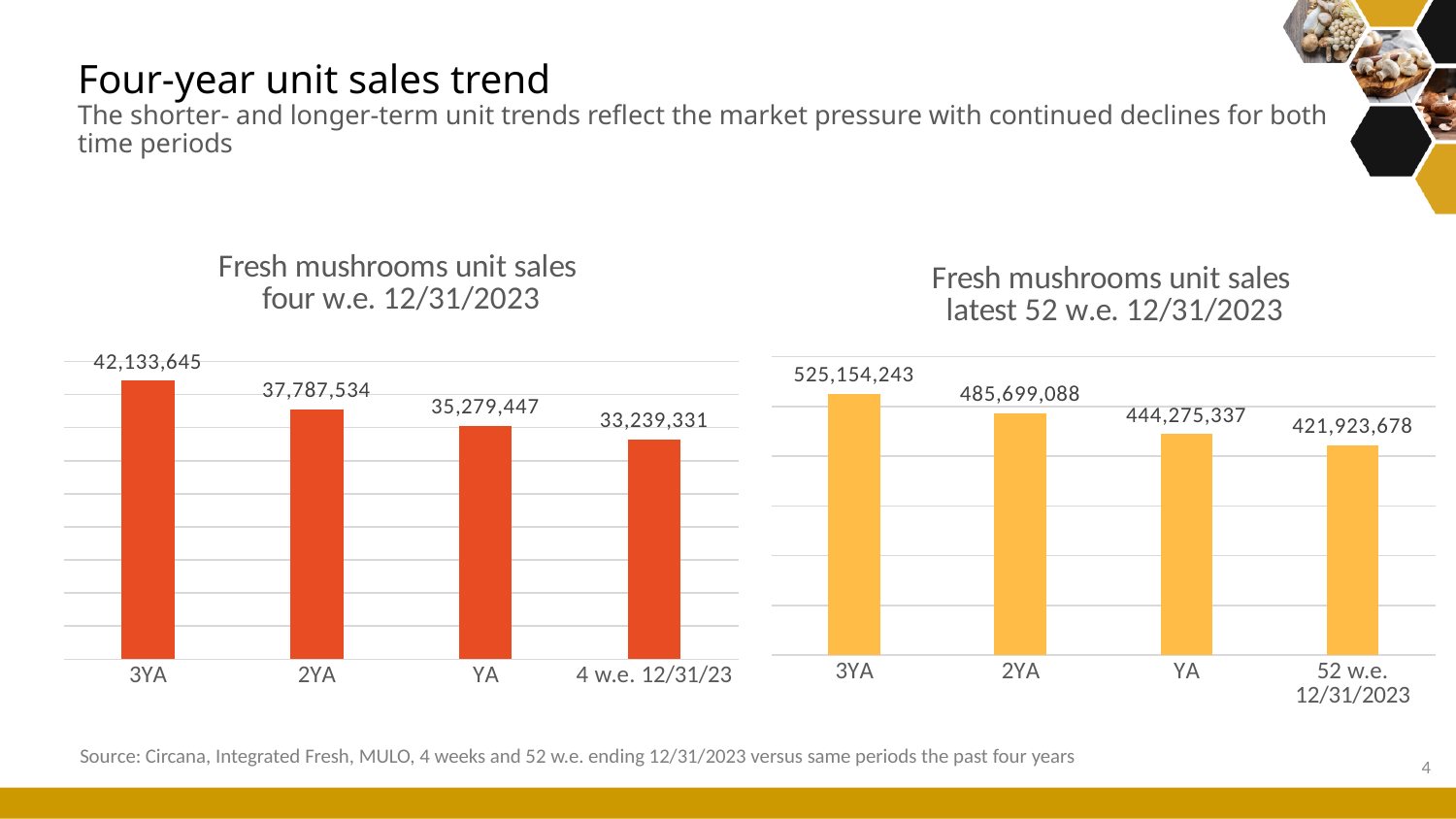
In the 'Fresh mushrooms unit sales latest 52 w.e. 12/31/2023' chart, do the values rise or fall from 3YA to 52 w.e. 12/31/2023? Fall In the 'Fresh mushrooms unit sales latest 52 w.e. 12/31/2023' chart, which category has the highest value? 3YA In the 'Fresh mushrooms unit sales four w.e. 12/31/2023' chart, what is the difference between the 3YA value and the 4 w.e. 12/31/23 value? 8,894,314 In the 'Fresh mushrooms unit sales four w.e. 12/31/2023' chart, what is the value for 3YA? 42,133,645 In the 'Fresh mushrooms unit sales four w.e. 12/31/2023' chart, what is the value for 4 w.e. 12/31/23? 33,239,331 In the 'Fresh mushrooms unit sales latest 52 w.e. 12/31/2023' chart, what is the value for 52 w.e. 12/31/2023? 421,923,678 How many categories are shown in the 'Fresh mushrooms unit sales latest 52 w.e. 12/31/2023' chart? 4 In the 'Fresh mushrooms unit sales four w.e. 12/31/2023' chart, which is larger, the value for 2YA or the value for YA? 2YA In the 'Fresh mushrooms unit sales latest 52 w.e. 12/31/2023' chart, what is the value for 2YA? 485,699,088 What kind of chart is the 'Fresh mushrooms unit sales four w.e. 12/31/2023' chart? Bar chart In the 'Fresh mushrooms unit sales latest 52 w.e. 12/31/2023' chart, what is the difference between the YA value and the 52 w.e. 12/31/2023 value? 22,351,659 In the 'Fresh mushrooms unit sales four w.e. 12/31/2023' chart, which category has the lowest value? 4 w.e. 12/31/23